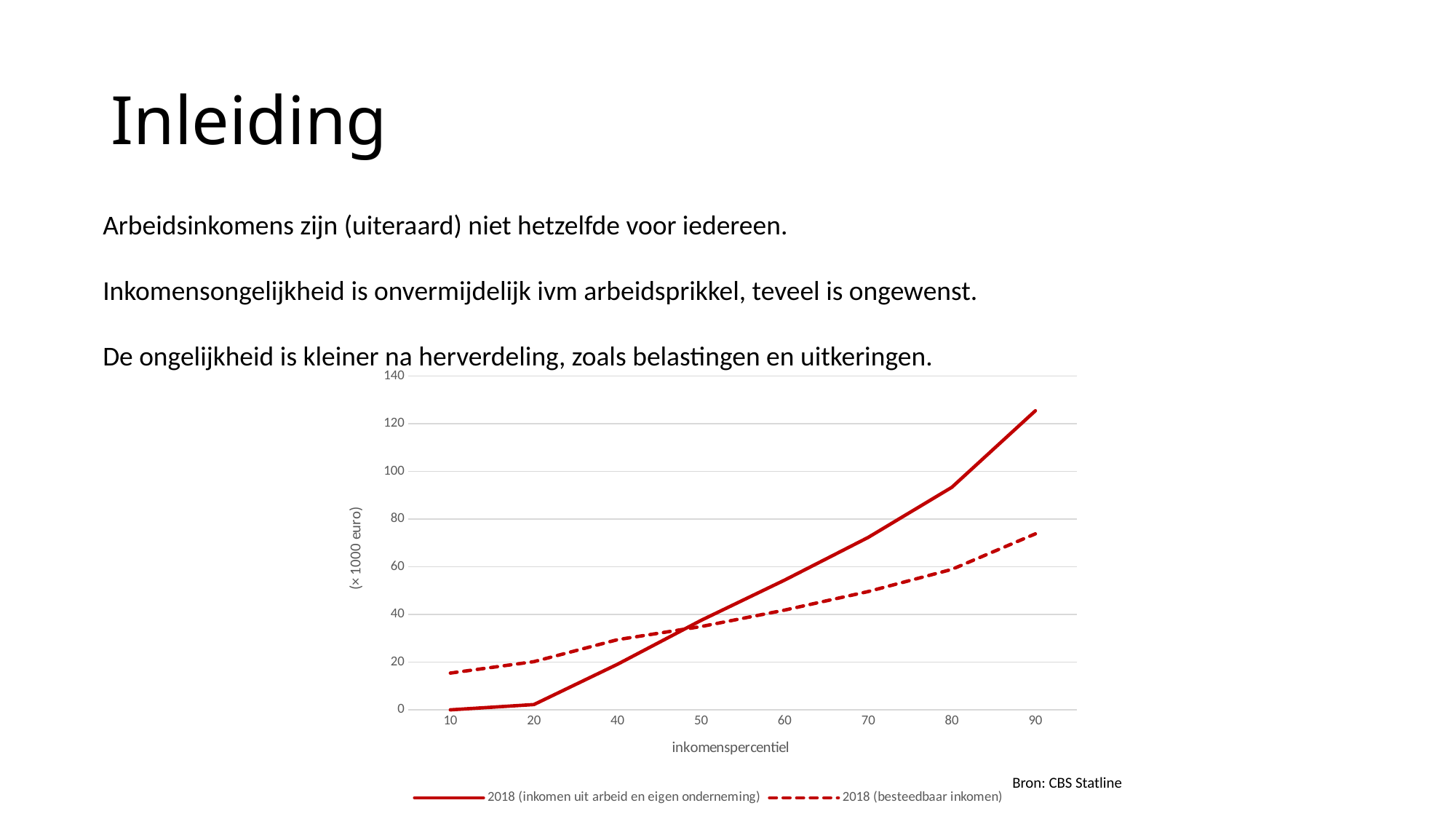
At income percentile 10, which series has the higher value: '2018 (inkomen uit arbeid en eigen onderneming)' or '2018 (besteedbaar inkomen)'? 2018 (besteedbaar inkomen) At income percentile 90, which series has the higher value: '2018 (inkomen uit arbeid en eigen onderneming)' or '2018 (besteedbaar inkomen)'? 2018 (inkomen uit arbeid en eigen onderneming) What kind of chart is shown on the slide? line chart Is the value of '2018 (inkomen uit arbeid en eigen onderneming)' at percentile 80 greater or less than 80? greater Do the values of the solid line '2018 (inkomen uit arbeid en eigen onderneming)' rise or fall as the income percentile increases? rise What is the title of the x axis of the chart? inkomenspercentiel How many series does the chart legend list? 2 Is the value of '2018 (besteedbaar inkomen)' at percentile 90 greater or less than 80? less What unit label is shown on the y axis of the chart? (× 1000 euro) Is the value of '2018 (besteedbaar inkomen)' at percentile 10 greater or less than 20? less How many income percentile points are marked along the x axis of the chart? 8